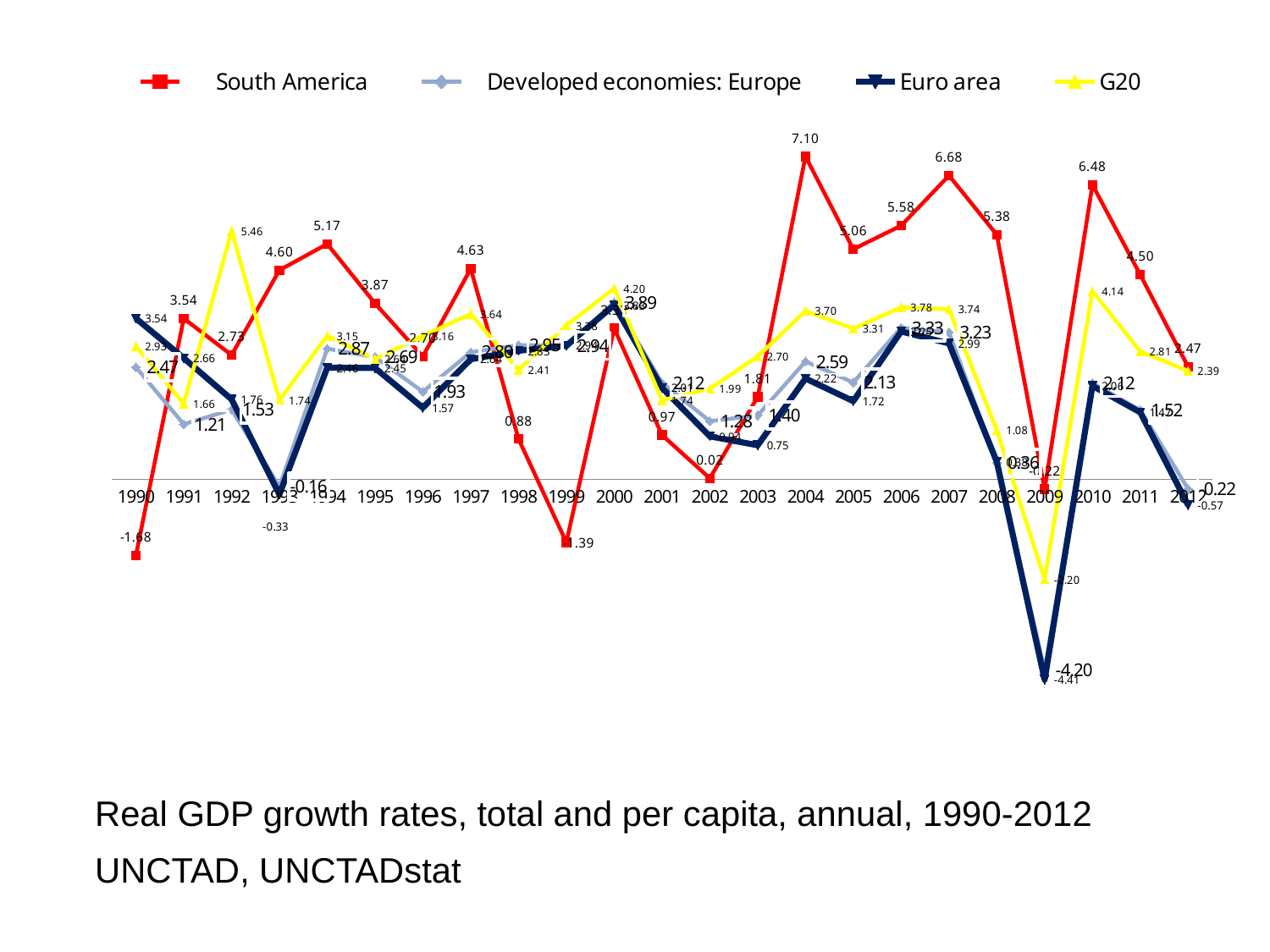
What is the difference between the South America values for 2004 and 2005? 2.04 What kind of chart is shown on the slide? line chart What is the value for South America in 2004? 7.10 How many series does the legend list? 4 What is the value for G20 in 1992? 5.46 In which year does South America reach its highest value? 2004 Which is larger, the South America value for 2010 or for 2011? 2010 What is the value for South America in 2007? 6.68 What is the value for G20 in 2009? -2.20 What is the value for South America in 1990? -1.68 Which series is shown in red in the legend? South America How many years are plotted along the x axis? 23